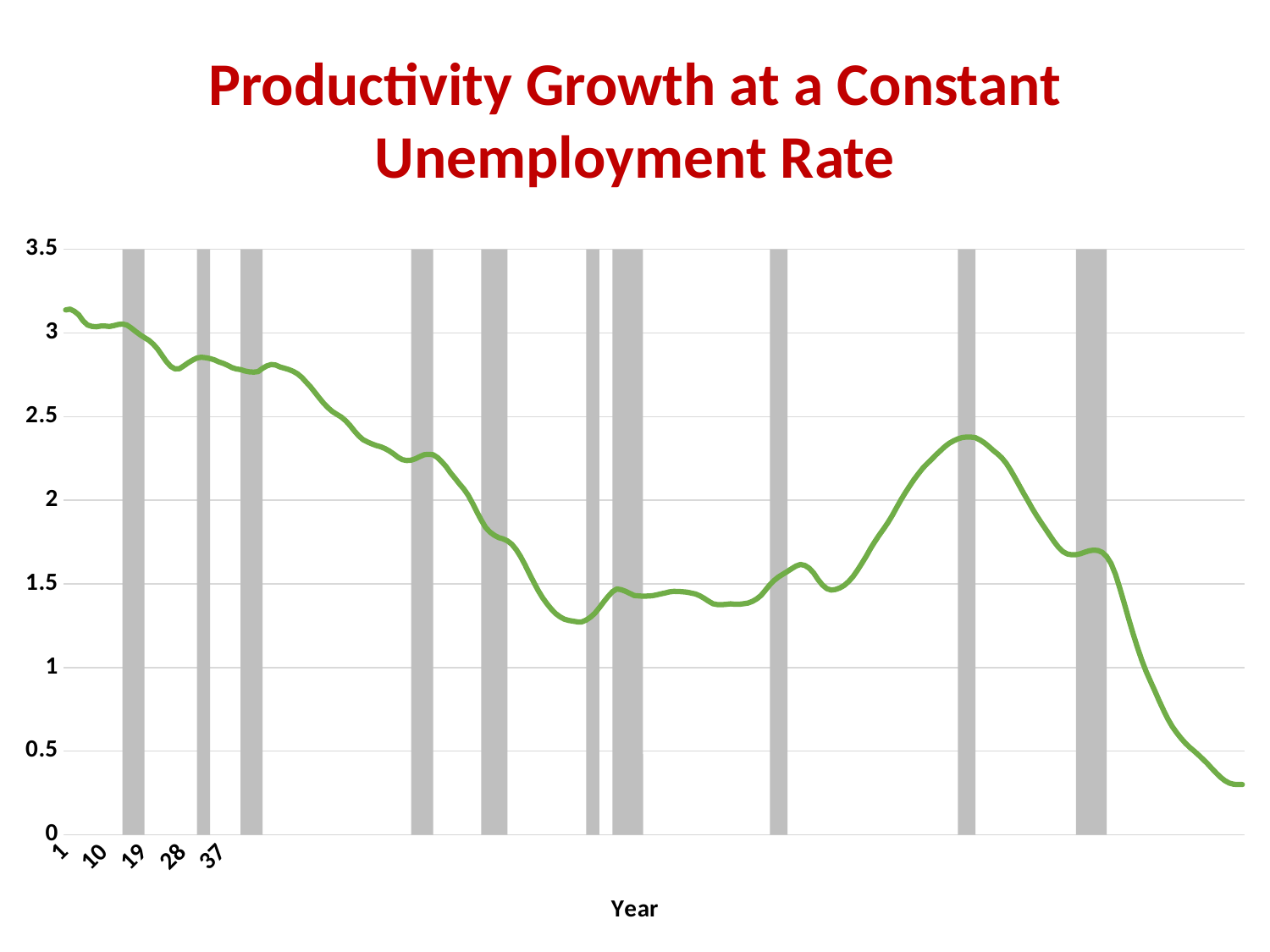
What is the highest value shown on the y axis? 3.5 What kind of chart is shown on the slide? line chart Which is larger, the value at year 1 or the value at the right end of the line? year 1 Is the value at year 37 greater or less than 2.5? greater Is the value at year 28 greater or less than 3? less Is the highest point of the line greater or less than 3? greater What is the label on the x axis of the chart? Year Overall, does the line rise or fall from the left end of the x axis to the right end? fall What is the title of the chart? Productivity Growth at a Constant Unemployment Rate